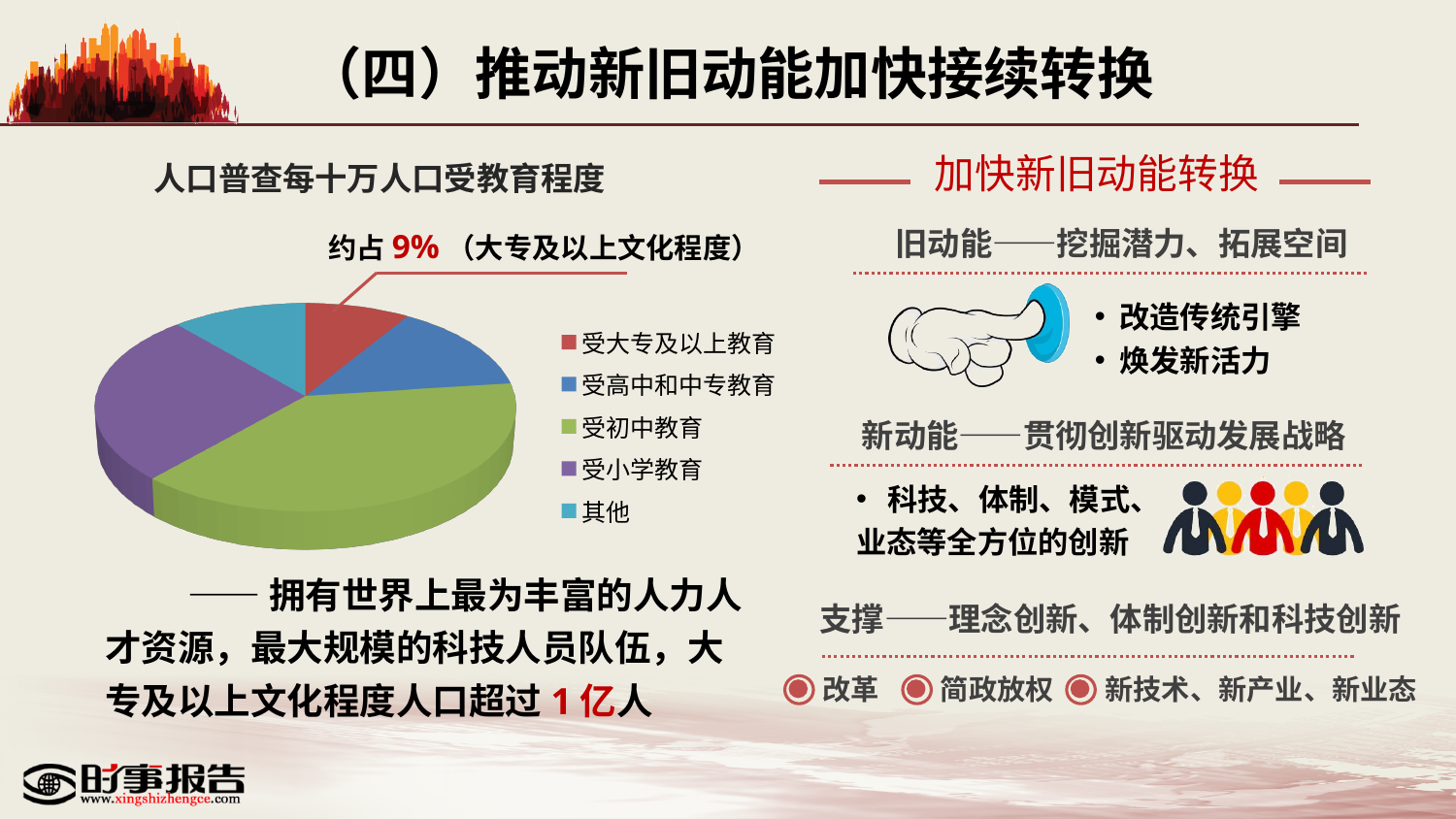
What is the title of the pie chart? 人口普查每十万人口受教育程度 How many categories does the pie chart's legend list? 5 Which slice is larger, 受初中教育 or 受小学教育? 受初中教育 Which slice is larger, 受高中和中专教育 or 受初中教育? 受初中教育 Which legend entry is listed last in the pie chart's legend? 其他 Which category has the largest slice in the pie chart? 受初中教育 Which slice is larger, 受小学教育 or 受大专及以上教育? 受小学教育 What kind of chart is shown on the slide? pie chart What colour is the 受初中教育 slice in the pie chart? green What share of the pie does 受大专及以上教育 account for, according to the callout? 9%